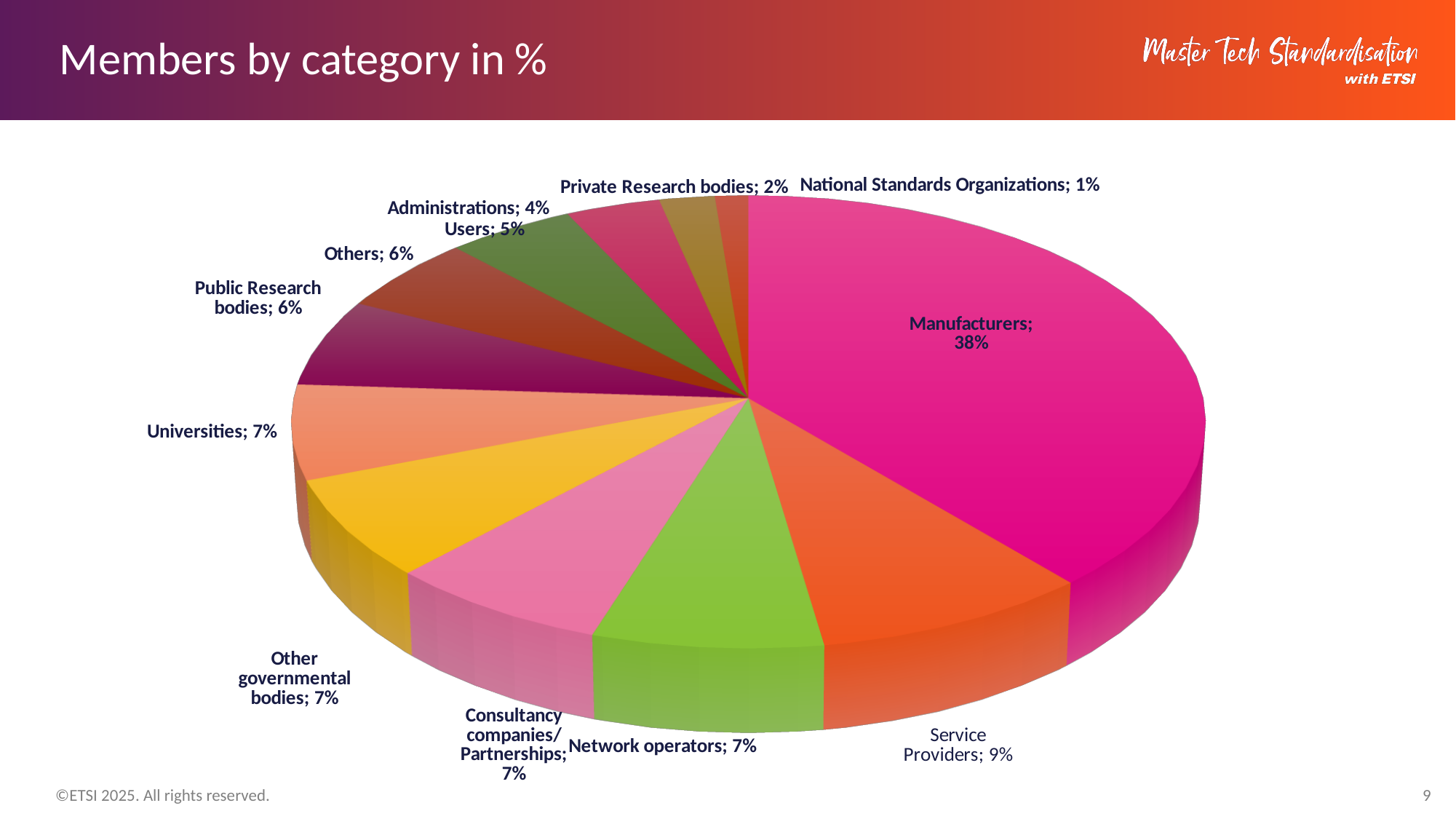
Which has a larger share, Administrations or Private Research bodies? Administrations What share of members are Manufacturers? 38% How many categories are shown in the pie chart? 12 What share of members are Service Providers? 9% Which category has the smallest share of members? National Standards Organizations Which category has the largest share of members? Manufacturers What is the title of the chart? Members by category in % What type of chart is shown on the slide? Pie chart What is the difference in percentage points between Universities and Administrations? 3 What share of members are Users? 5% What share of members are National Standards Organizations? 1% What is the difference in percentage points between Manufacturers and Service Providers? 29